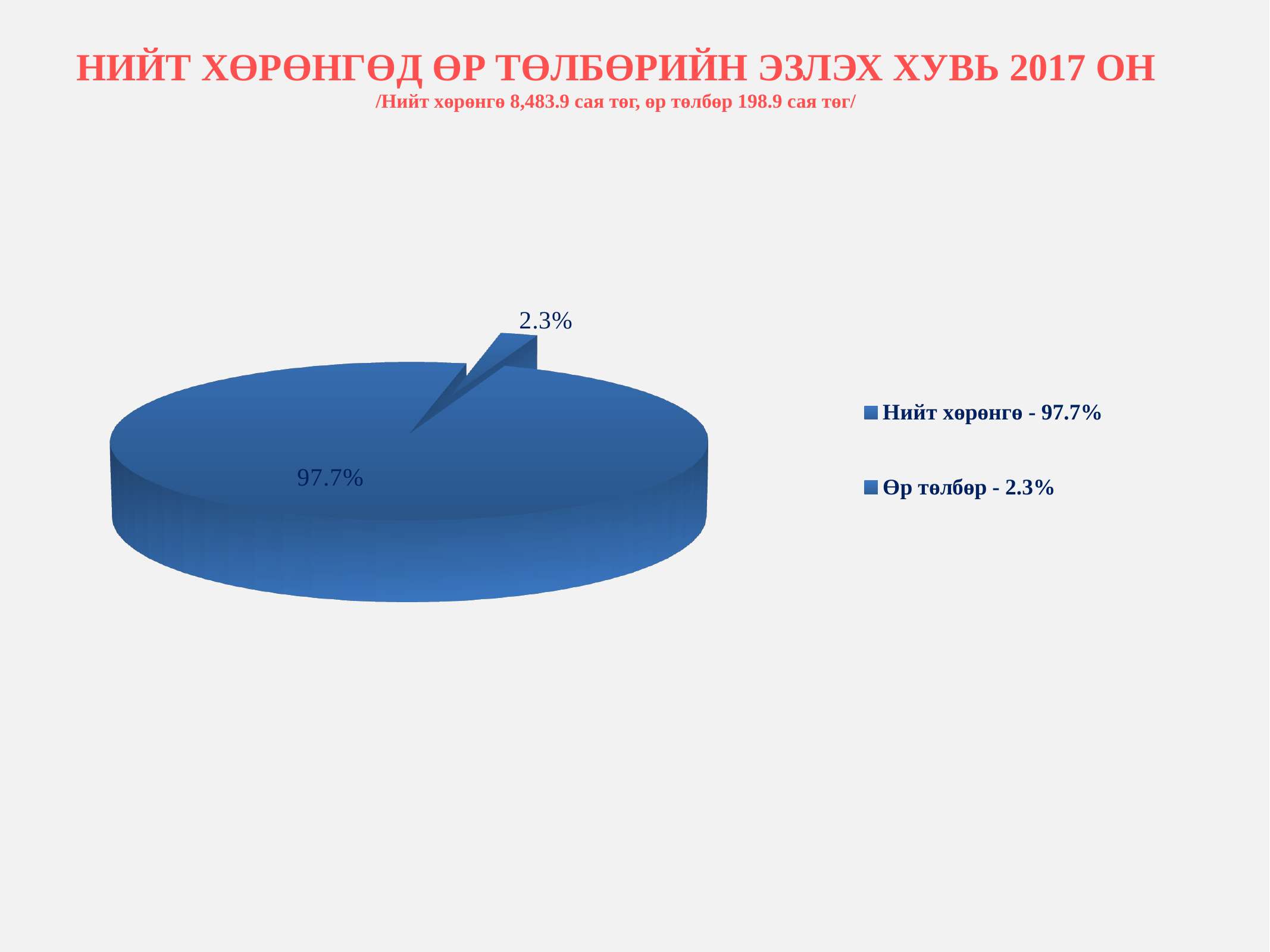
What share of the pie does Нийт хөрөнгө take? 97.7% What colour are the slices of the pie chart? Blue Which slice of the pie is the largest? Нийт хөрөнгө What is the difference in percentage points between the Нийт хөрөнгө slice and the Өр төлбөр slice? 95.4 How many slices does the pie chart have? 2 Which slice of the pie is the smallest? Өр төлбөр Which is larger, the Нийт хөрөнгө slice or the Өр төлбөр slice? Нийт хөрөнгө What kind of chart is shown on the slide? Pie chart What is the title of the chart on the slide? НИЙТ ХӨРӨНГӨД ӨР ТӨЛБӨРИЙН ЭЗЛЭХ ХУВЬ 2017 ОН What share of the pie does Өр төлбөр take? 2.3% How many entries does the legend list? 2